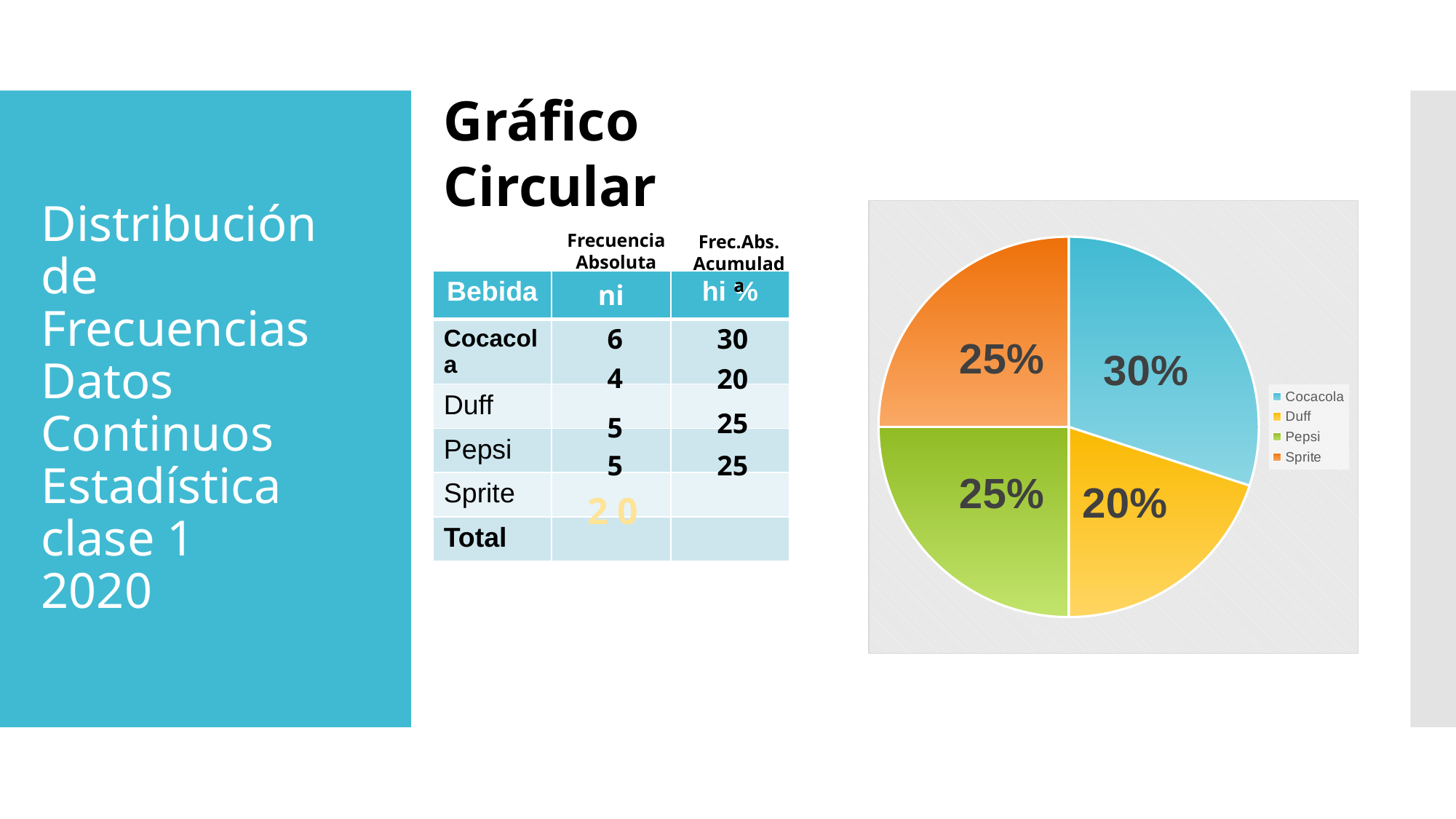
How many entries does the pie chart legend list? 4 What is the difference in percentage points between the Cocacola slice and the Duff slice? 10 What percentage of the pie chart does Cocacola represent? 30% What percentage of the pie chart does Sprite represent? 25% What colour is the Sprite slice in the pie chart? orange What kind of chart is shown on the slide? pie chart Which drink has the largest slice in the pie chart? Cocacola What percentage of the pie chart does Duff represent? 20% Which drink has the smallest slice in the pie chart? Duff Which slice is larger in the pie chart, Cocacola or Pepsi? Cocacola How many slices does the pie chart have? 4 What percentage of the pie chart does Pepsi represent? 25%